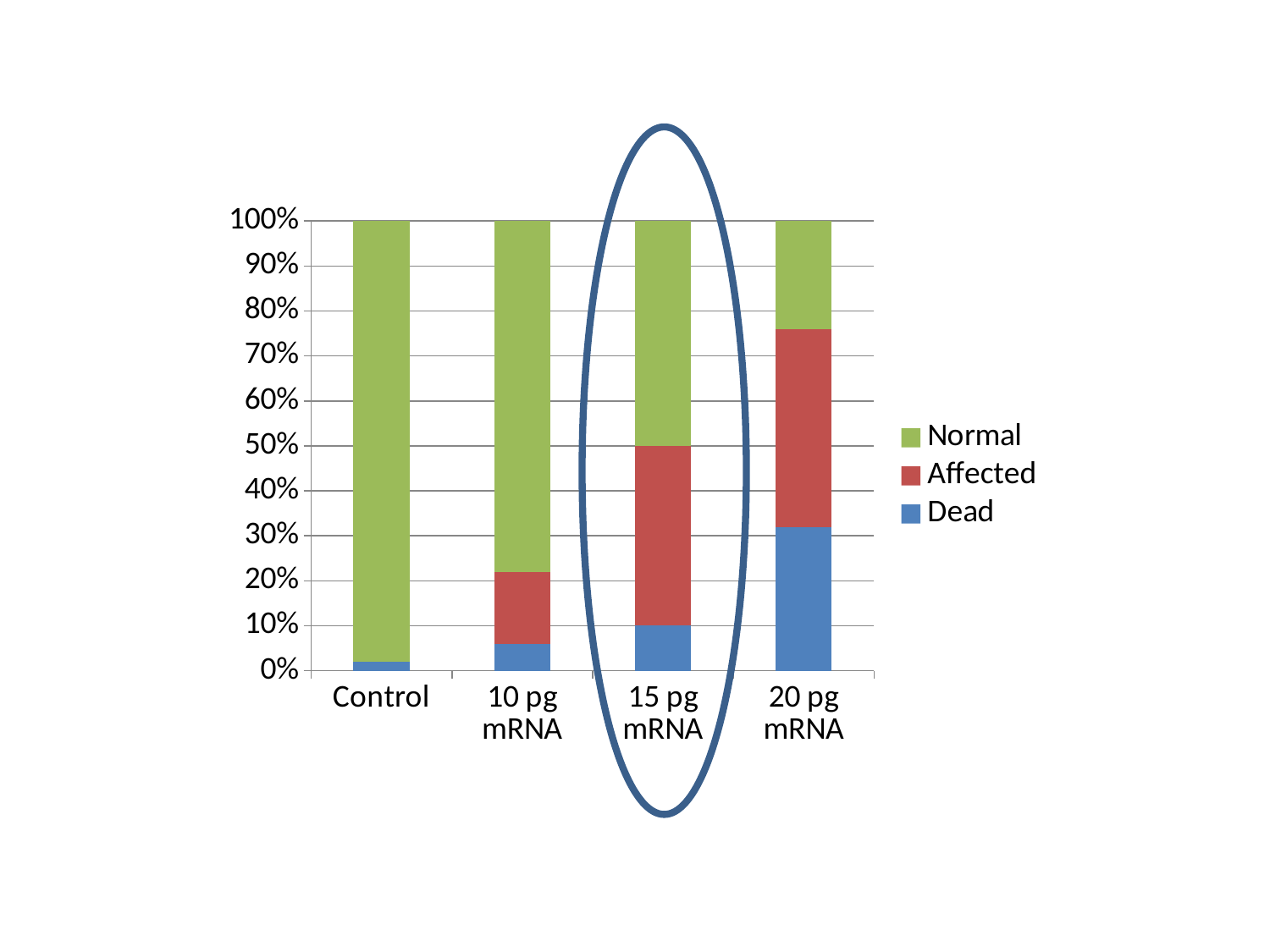
Which category is circled on the slide? 15 pg mRNA Which category has the largest Normal share? Control Which category has the largest Dead share? 20 pg mRNA Is the Dead share for 20 pg mRNA greater or less than 30%? greater Is the Dead share for 10 pg mRNA greater or less than 10%? less How many categories are shown on the x axis? 4 Does the Dead share rise or fall moving from Control to 20 pg mRNA? rise Which category has the smallest Dead share? Control What kind of chart is shown on the slide? Stacked bar chart How many series does the legend list? 3 What is the total of the stacked bar for 15 pg mRNA? 100% Is the Normal share for 20 pg mRNA greater or less than 30%? less